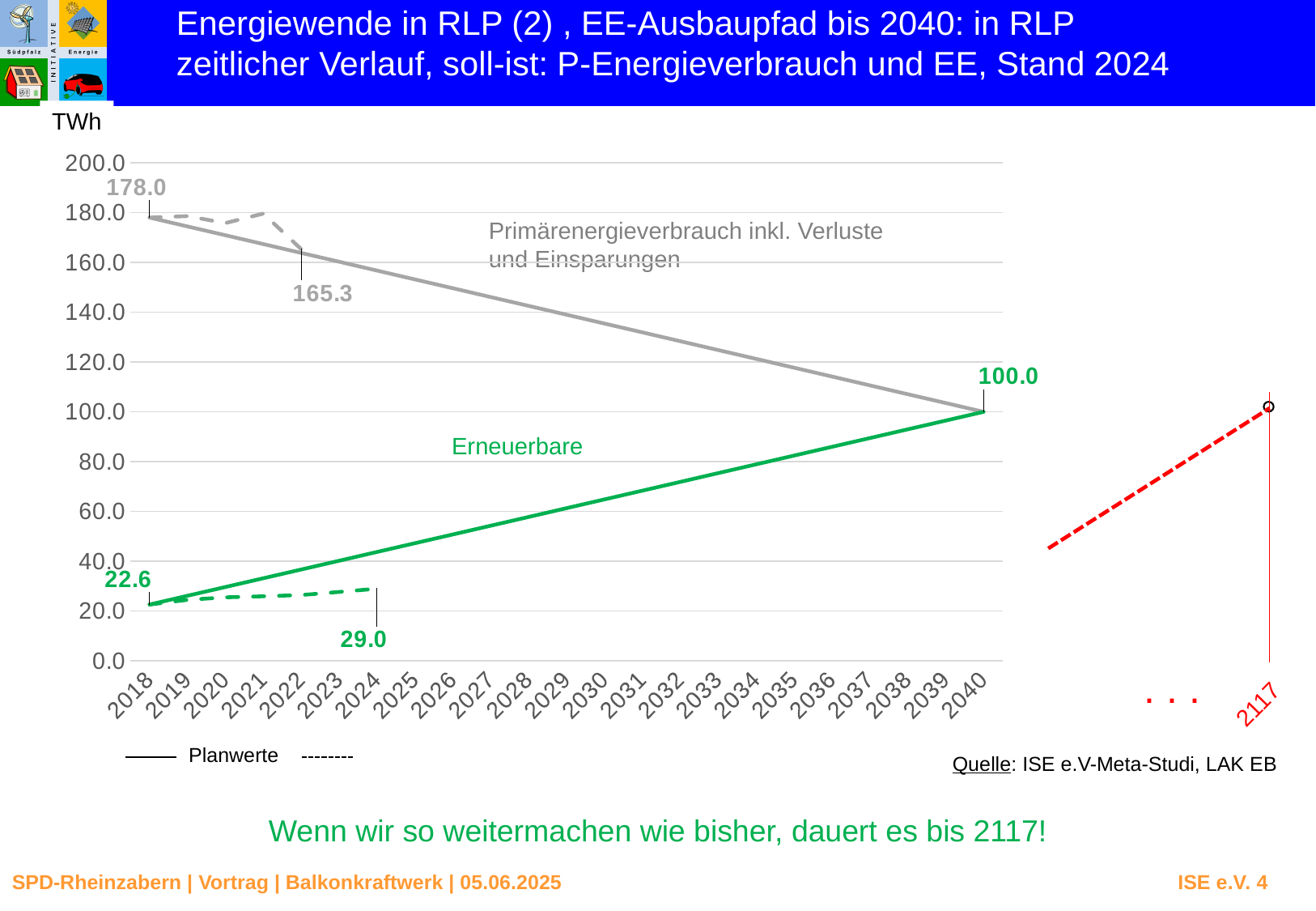
What unit is shown on the y axis of the chart? TWh What value do both lines reach in 2040? 100.0 What value is labelled for the Erneuerbare actual (dashed) line in 2024? 29.0 Does the Erneuerbare plan line rise or fall from 2018 to 2040? rise What is the difference between the Primärenergieverbrauch value in 2018 (178.0) and the planned value in 2040 (100.0)? 78.0 What value is labelled for the Primärenergieverbrauch actual (dashed) line in 2022? 165.3 What is the value of Erneuerbare in 2018? 22.6 What is the value of Primärenergieverbrauch in 2018? 178.0 Is the planned Erneuerbare value for 2030 greater or less than 40.0? greater Which series has the higher value in 2018, Primärenergieverbrauch or Erneuerbare? Primärenergieverbrauch What is the difference between the Erneuerbare value in 2024 (29.0) and in 2018 (22.6)? 6.4 What type of chart is shown on the slide? line chart